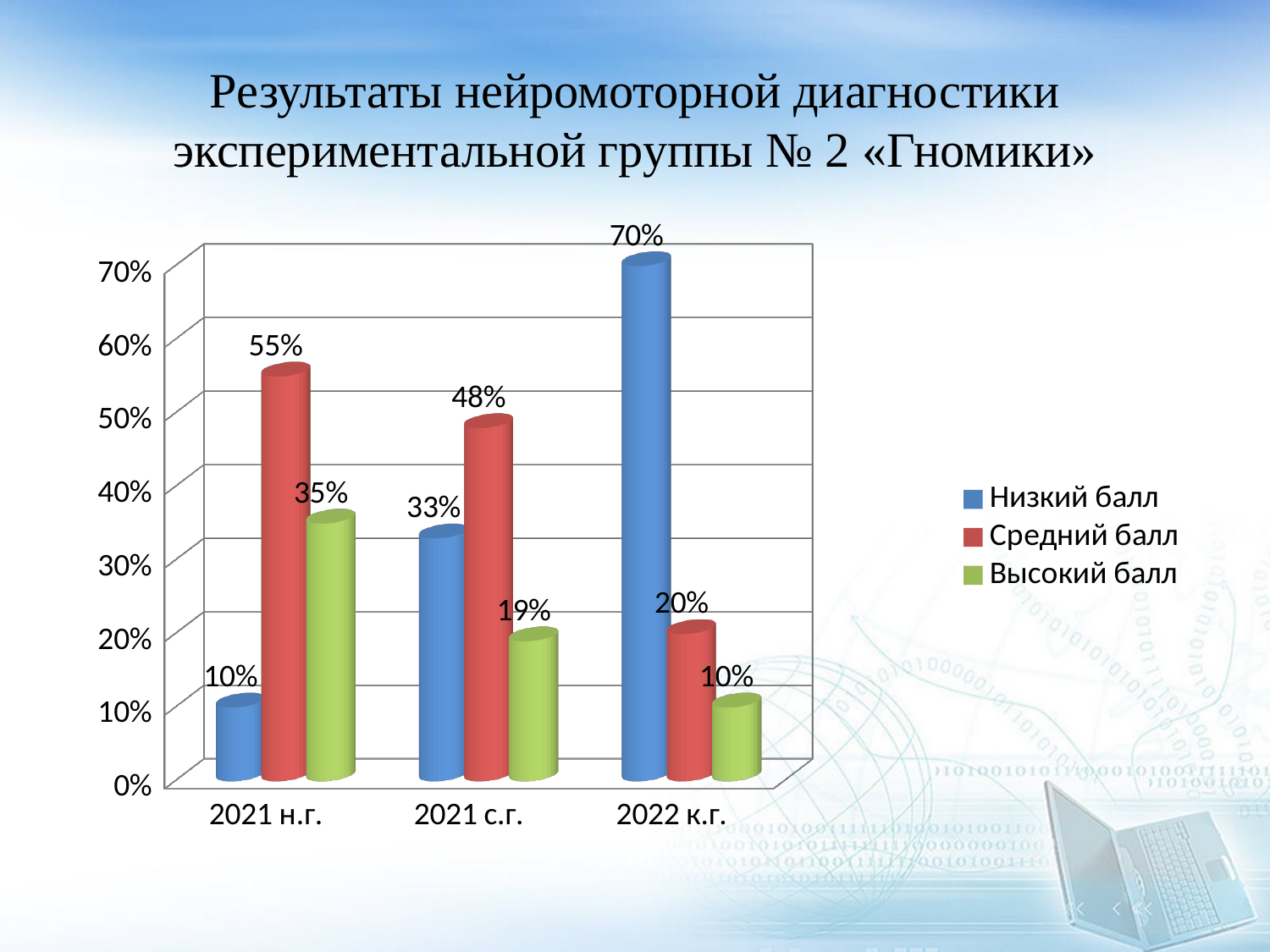
What is the value for Низкий балл in 2021 н.г.? 10% Does the Средний балл value rise or fall from 2021 н.г. to 2022 к.г.? Fall What is the difference between the Низкий балл values for 2022 к.г. and 2021 н.г.? 60% What is the value for Средний балл in 2021 с.г.? 48% What is the value for Высокий балл in 2022 к.г.? 10% What kind of chart is shown on the slide? Bar chart How many categories are shown on the x axis? 3 Which colour represents Высокий балл in the legend? Green Which is larger in 2021 с.г.: Низкий балл or Средний балл? Средний балл How many series does the legend list? 3 In which category is the Низкий балл value highest? 2022 к.г. In which category is the Высокий балл value lowest? 2022 к.г.